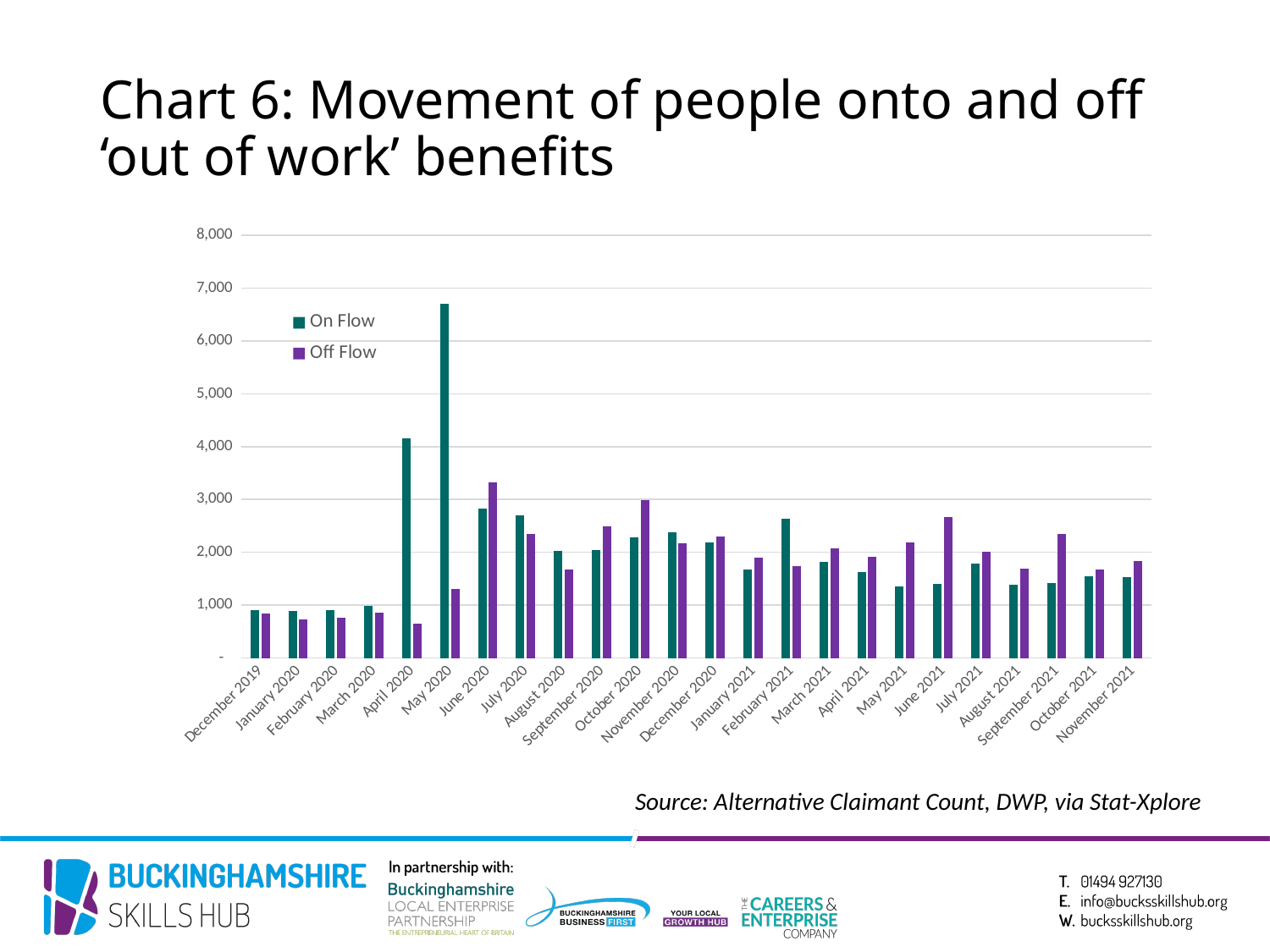
In June 2021, which is larger, On Flow or Off Flow? Off Flow In which month is the Off Flow value lowest? April 2020 Is the On Flow value for April 2020 greater or less than 3,000? greater In which month is the On Flow value highest? May 2020 What are the two series named in the legend? On Flow and Off Flow How many months are shown on the x axis? 24 What kind of chart is shown on the slide? Bar chart In which month is the Off Flow value highest? June 2020 Is the On Flow value for May 2020 greater or less than 6,000? greater Is the Off Flow value for April 2020 greater or less than 1,000? less How many series does the legend list? 2 Does the On Flow value rise or fall from May 2020 to August 2020? Fall